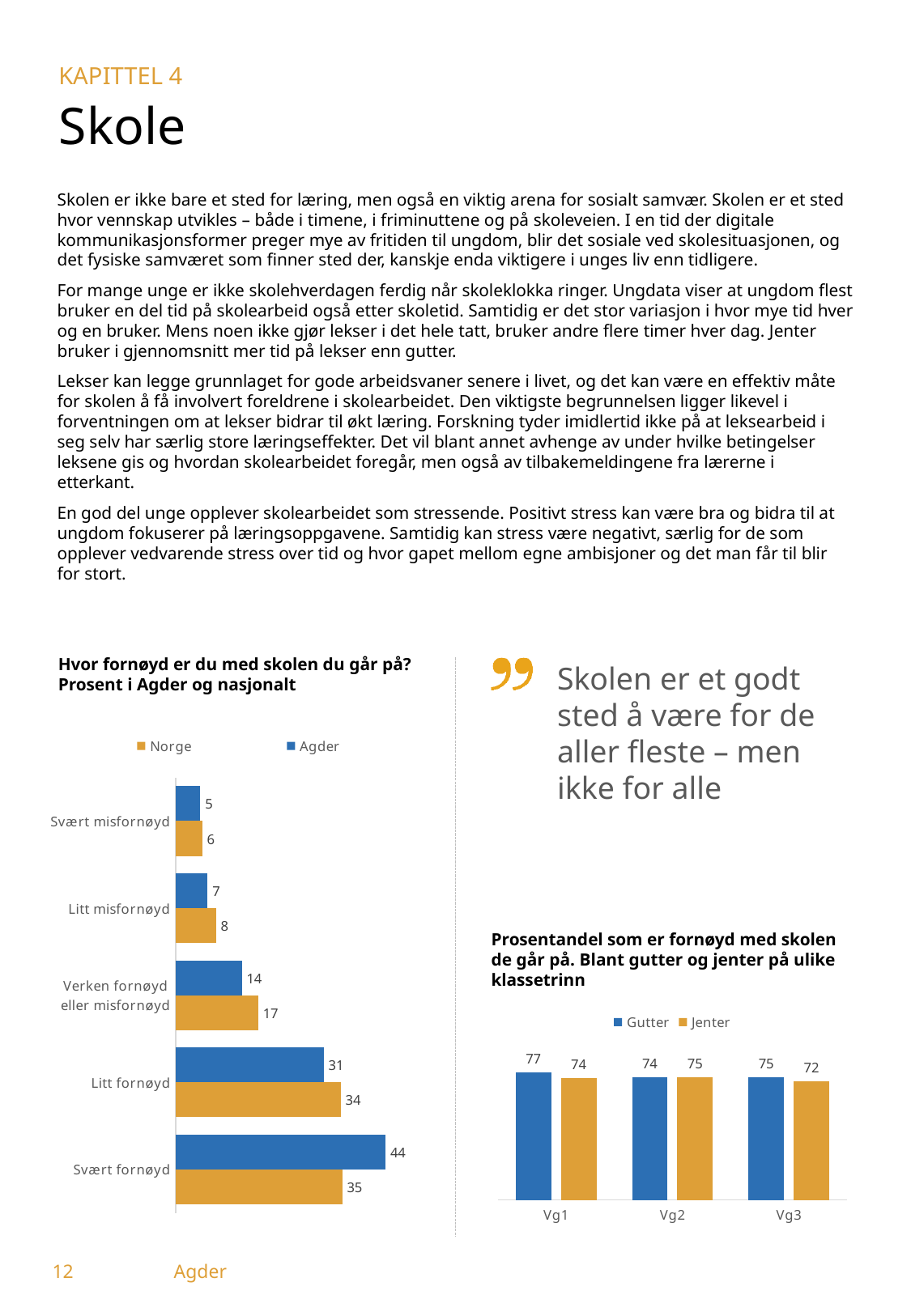
What kind of chart is 'Prosentandel som er fornøyd med skolen de går på'? Bar chart How many categories are shown in the chart 'Hvor fornøyd er du med skolen du går på?'? 5 In the chart 'Prosentandel som er fornøyd med skolen de går på', which is larger at Vg2: Gutter or Jenter? Jenter In the chart 'Hvor fornøyd er du med skolen du går på?', which category has the highest value for Agder? Svært fornøyd In the chart 'Hvor fornøyd er du med skolen du går på?', what is the value for Agder in the category 'Svært fornøyd'? 44 In the chart 'Hvor fornøyd er du med skolen du går på?', what is the difference between Agder and Norge in the category 'Svært fornøyd'? 9 In the chart 'Hvor fornøyd er du med skolen du går på?', which category has the lowest value for Norge? Svært misfornøyd In the chart 'Prosentandel som er fornøyd med skolen de går på', what is the value for Gutter at Vg1? 77 How many series does the legend list in the chart 'Hvor fornøyd er du med skolen du går på?'? 2 In the chart 'Hvor fornøyd er du med skolen du går på?', which is larger in the category 'Verken fornøyd eller misfornøyd': Norge or Agder? Norge In the chart 'Hvor fornøyd er du med skolen du går på?', what is the value for Norge in the category 'Litt fornøyd'? 34 In the chart 'Prosentandel som er fornøyd med skolen de går på', what is the difference between Gutter and Jenter at Vg3? 3